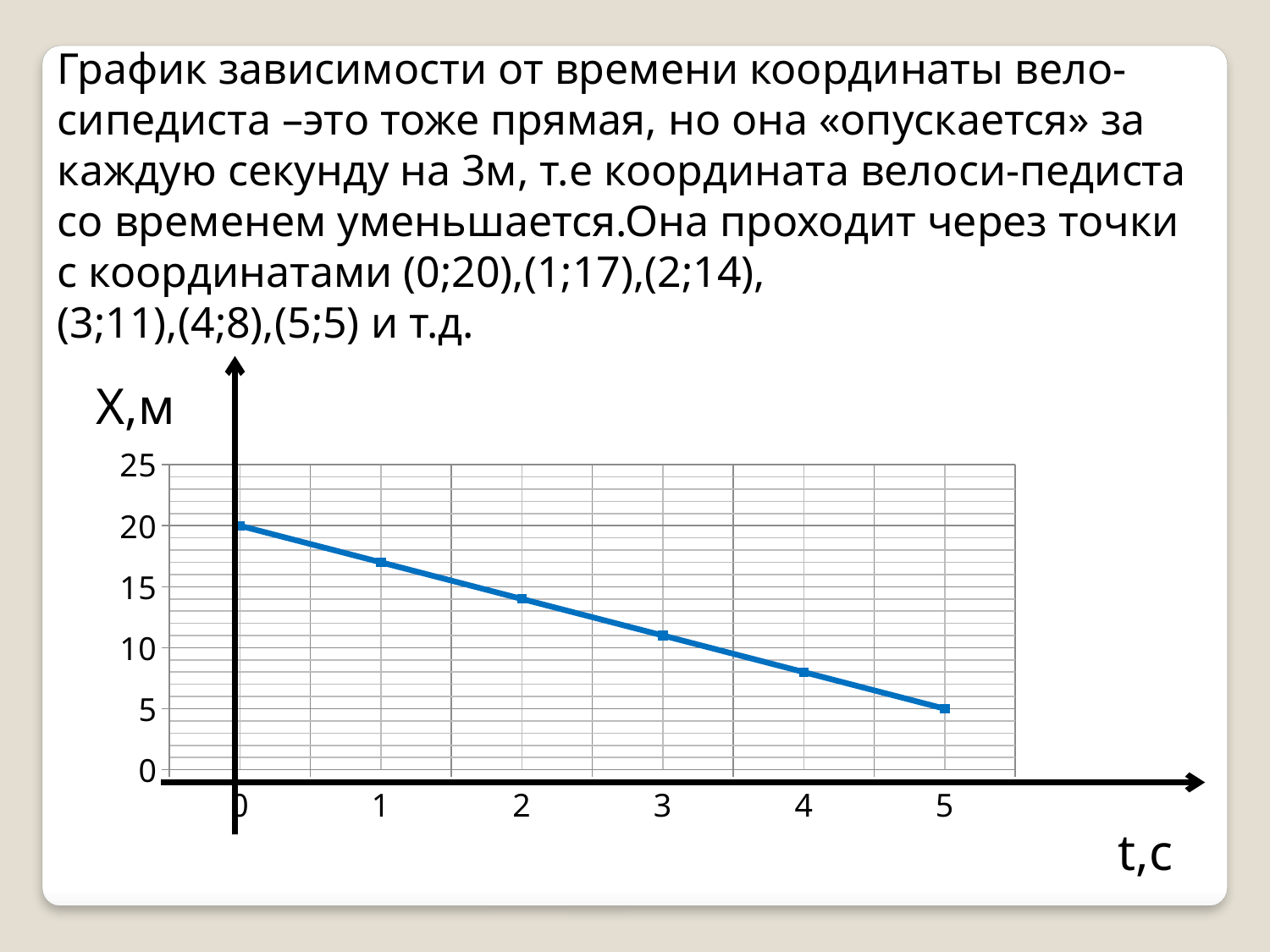
What is the value of X at t = 0 s? 20 At which time t is the coordinate X highest? 0 What is the value of X at t = 4 s? 8 How many data points are plotted on the line? 6 What is the value of X at t = 5 s? 5 Does the coordinate X rise or fall as time t increases? fall By how much does X decrease from t = 0 s to t = 5 s? 15 Which is larger, the value of X at t = 1 s or at t = 3 s? t = 1 s Is the value of X at t = 3 s greater or less than 15? less What type of chart is shown on the slide? line chart What is the value of X at t = 2 s? 14 At which time t is the coordinate X lowest? 5